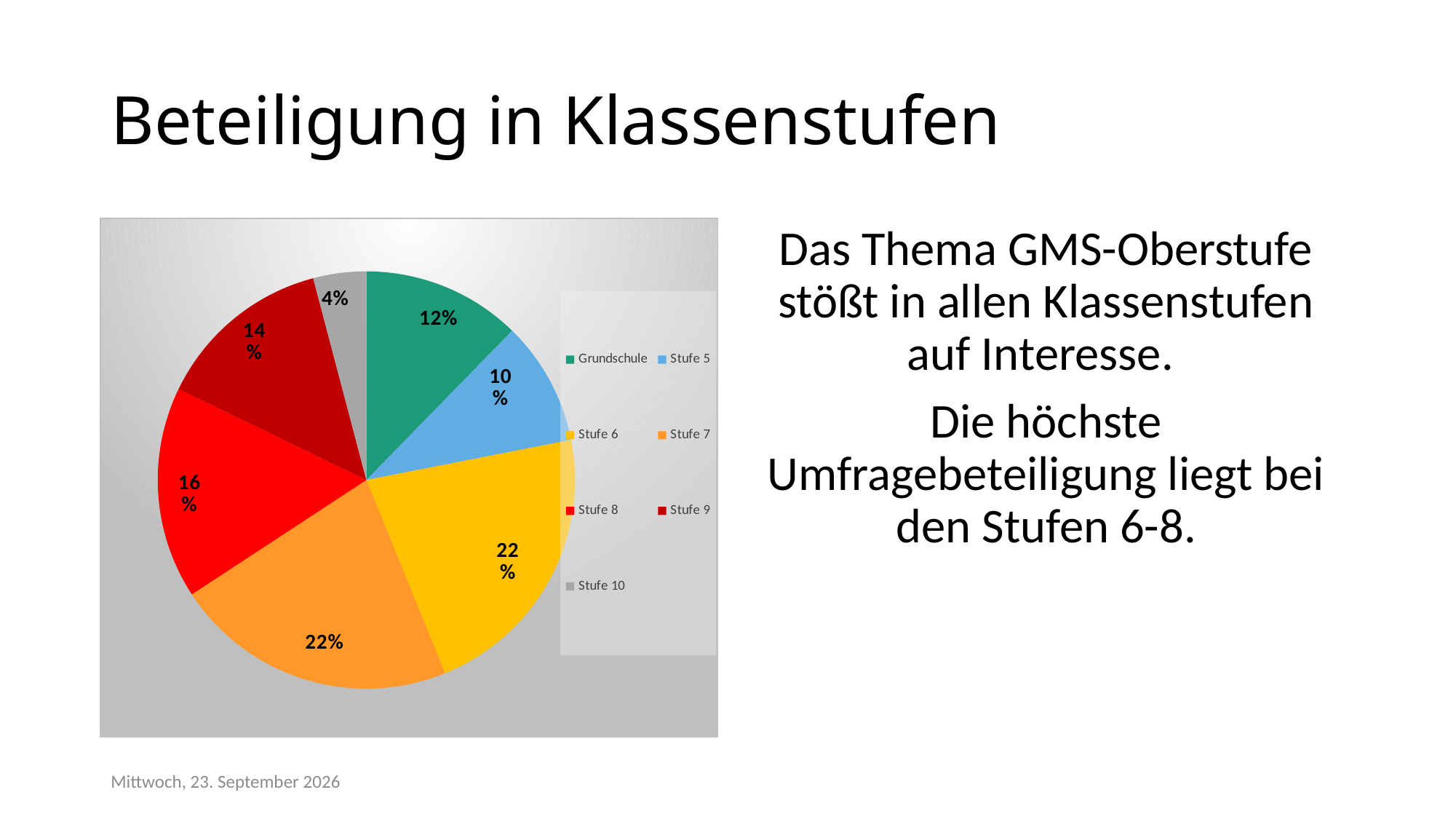
Which colour represents Stufe 10 in the pie chart? grey What kind of chart is shown on the slide? pie chart Which category has the smallest slice of the pie? Stufe 10 What percentage is shown for Stufe 8? 16% What percentage is shown for Stufe 5? 10% What is the difference in percentage points between Stufe 6 and Stufe 5? 12 What percentage is shown for Stufe 9? 14% How many categories does the legend of the pie chart list? 7 What percentage of the pie is labelled for Grundschule? 12% What percentage is shown for Stufe 10? 4% Which is larger, the slice for Stufe 8 or the slice for Stufe 9? Stufe 8 What is the combined share of Stufe 6 and Stufe 7? 44%